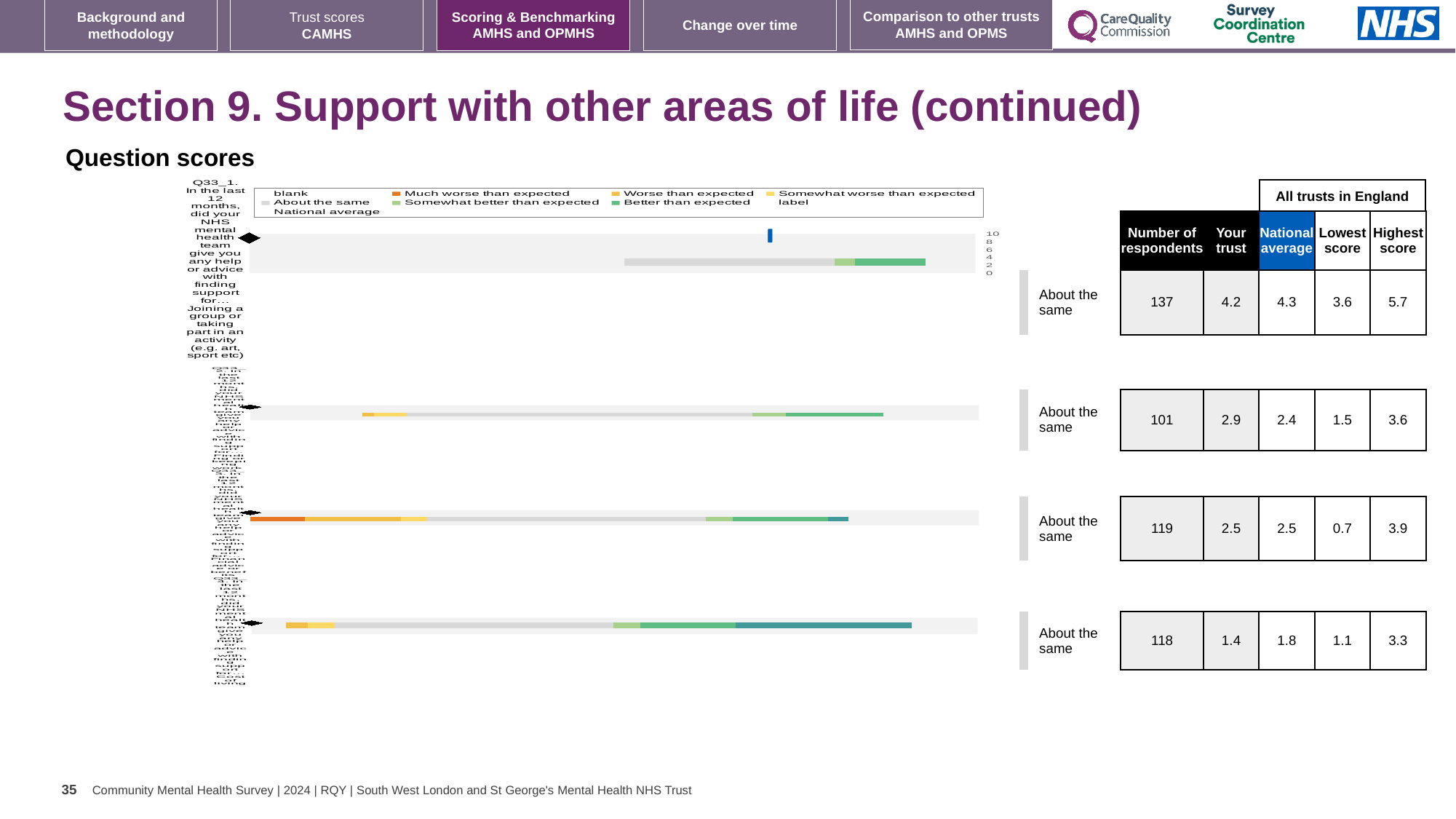
In the table beside the chart, what is the national average for the first question (Q33_1)? 4.3 What is the first legend entry listed in the chart legend? blank How many entries does the chart legend list? 9 In the table beside the chart, how many respondents answered the first question (Q33_1)? 137 In the table beside the chart, which is larger for the first question (Q33_1): the 'Your trust' score or the national average? National average What kind of chart is shown under 'Question scores'? bar chart In the table beside the chart, what is the 'Your trust' score for the first question (Q33_1, joining a group or taking part in an activity)? 4.2 Which legend entry is shown in orange-red in the chart? Much worse than expected What comparison label is shown next to each of the four bars in the chart? About the same In the table beside the chart, what is the highest score for the first question (Q33_1)? 5.7 In the table beside the chart, what is the difference between the highest score and the lowest score for the first question (Q33_1)? 2.1 How many question bars are plotted in the chart? 4